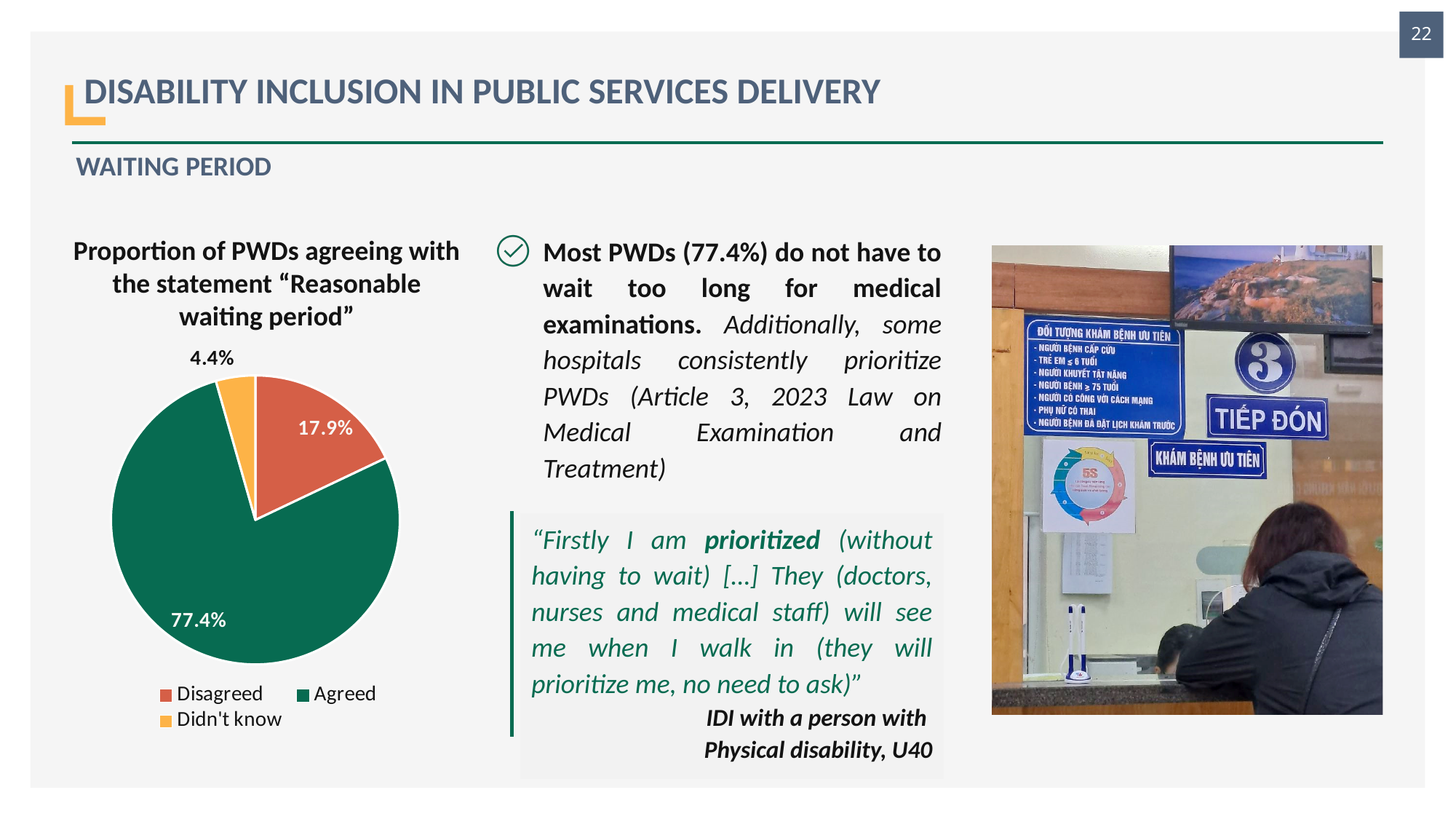
What is the difference in percentage points between Agreed and Disagreed? 59.5 What percentage of PWDs disagreed with the statement "Reasonable waiting period"? 17.9% What percentage of PWDs didn't know whether the waiting period was reasonable? 4.4% How many categories does the pie chart show? 3 What type of chart is shown on the slide? Pie chart What percentage of PWDs agreed with the statement "Reasonable waiting period"? 77.4% Which response category has the smallest share of the pie? Didn't know What colour represents the Agreed slice in the pie chart? Green What is the difference in percentage points between Disagreed and Didn't know? 13.5 What is the title of the pie chart? Proportion of PWDs agreeing with the statement "Reasonable waiting period" Which is larger, the share for Disagreed or the share for Didn't know? Disagreed Which response category has the largest share of the pie? Agreed